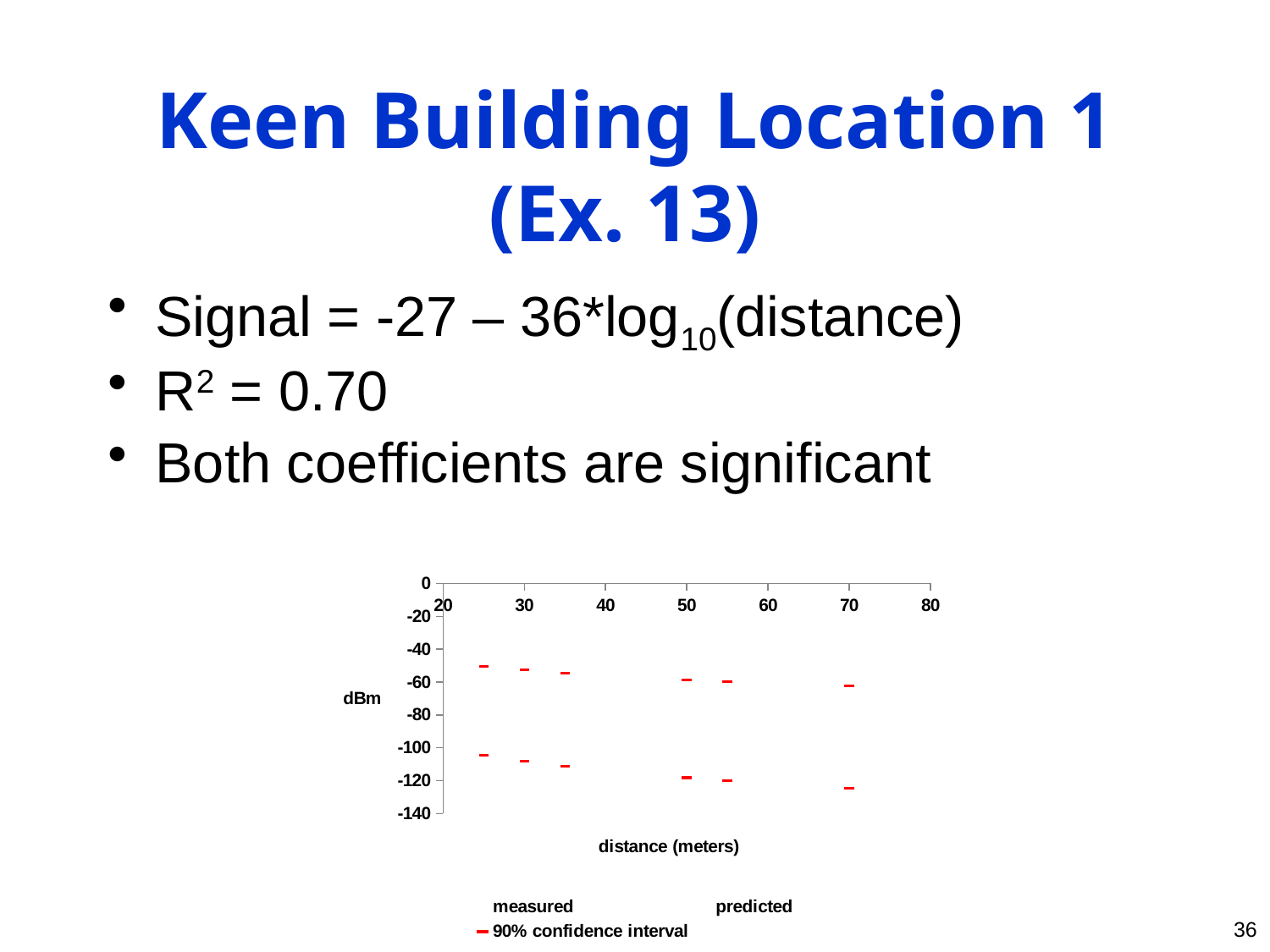
At how many distance values are 90% confidence interval markers plotted? 6 Is the lower 90% confidence interval marker at a distance of 25 meters greater or less than -120 dBm? greater Is the upper 90% confidence interval marker at 25 meters higher or lower than the one at 70 meters? higher Is the upper 90% confidence interval marker at a distance of 50 meters greater or less than -40 dBm? less Do the upper 90% confidence interval markers rise or fall as distance increases from 25 to 70 meters? fall What is the label of the vertical axis of the chart? dBm How many series does the chart legend list? 3 Is the lower 90% confidence interval marker at a distance of 70 meters greater or less than -120 dBm? less Which distance has the lowest lower 90% confidence interval marker, 25 meters or 70 meters? 70 meters What is the label of the horizontal axis of the chart? distance (meters) What kind of chart is shown on the slide? scatter chart